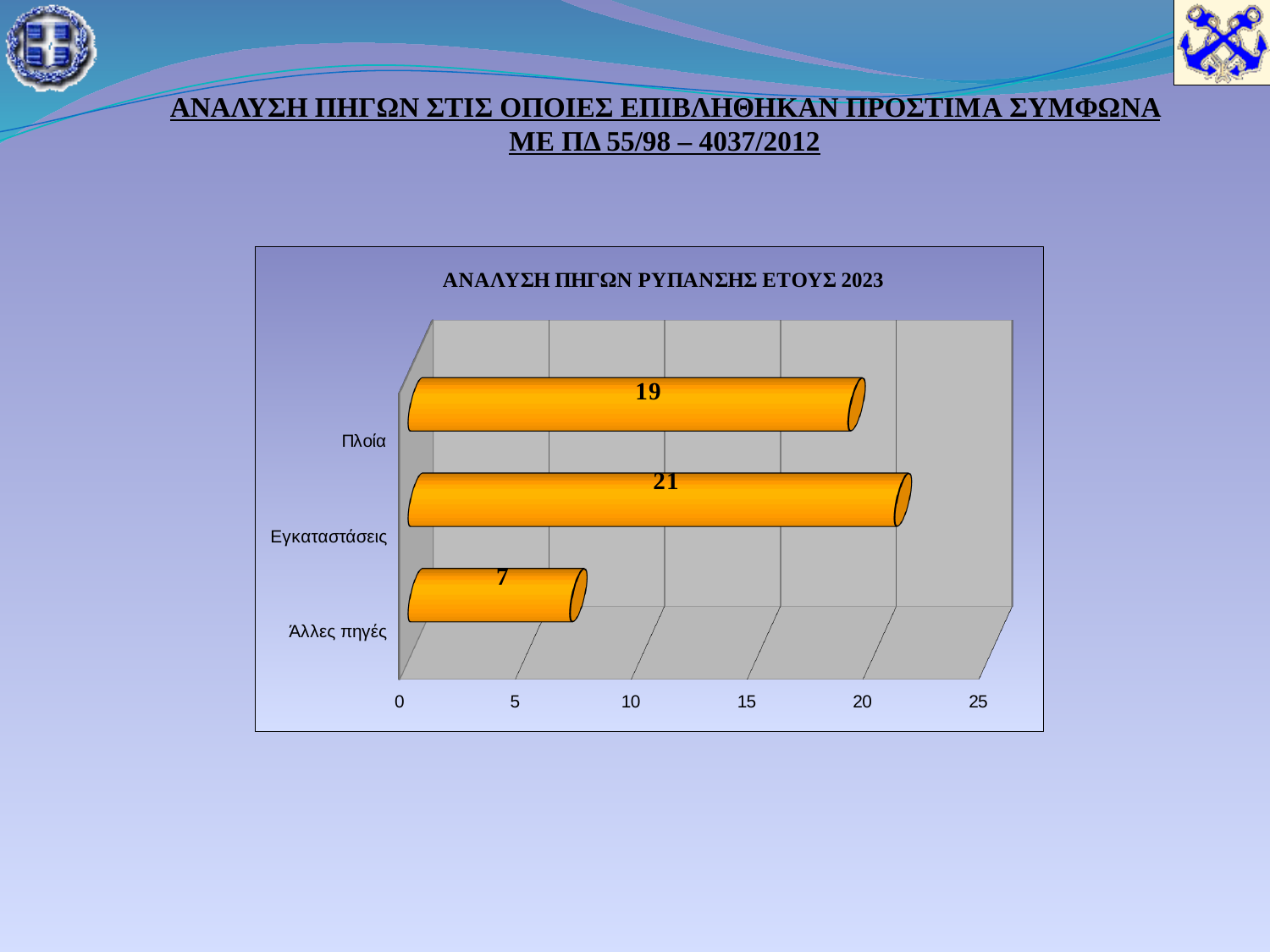
What is the value for Εγκαταστάσεις? 21 What is the difference between the values for Πλοία and Άλλες πηγές? 12 How many categories are shown in the chart? 3 Which is larger, the value for Πλοία or the value for Άλλες πηγές? Πλοία What is the value for Άλλες πηγές? 7 Is the value for Εγκαταστάσεις greater or less than 20? greater Which category has the lowest value? Άλλες πηγές What is the difference between the values for Εγκαταστάσεις and Πλοία? 2 What kind of chart is shown on the slide? bar chart What is the value for Πλοία? 19 Which category has the highest value? Εγκαταστάσεις What is the title of the chart? ΑΝΑΛΥΣΗ ΠΗΓΩΝ ΡΥΠΑΝΣΗΣ ΕΤΟΥΣ 2023